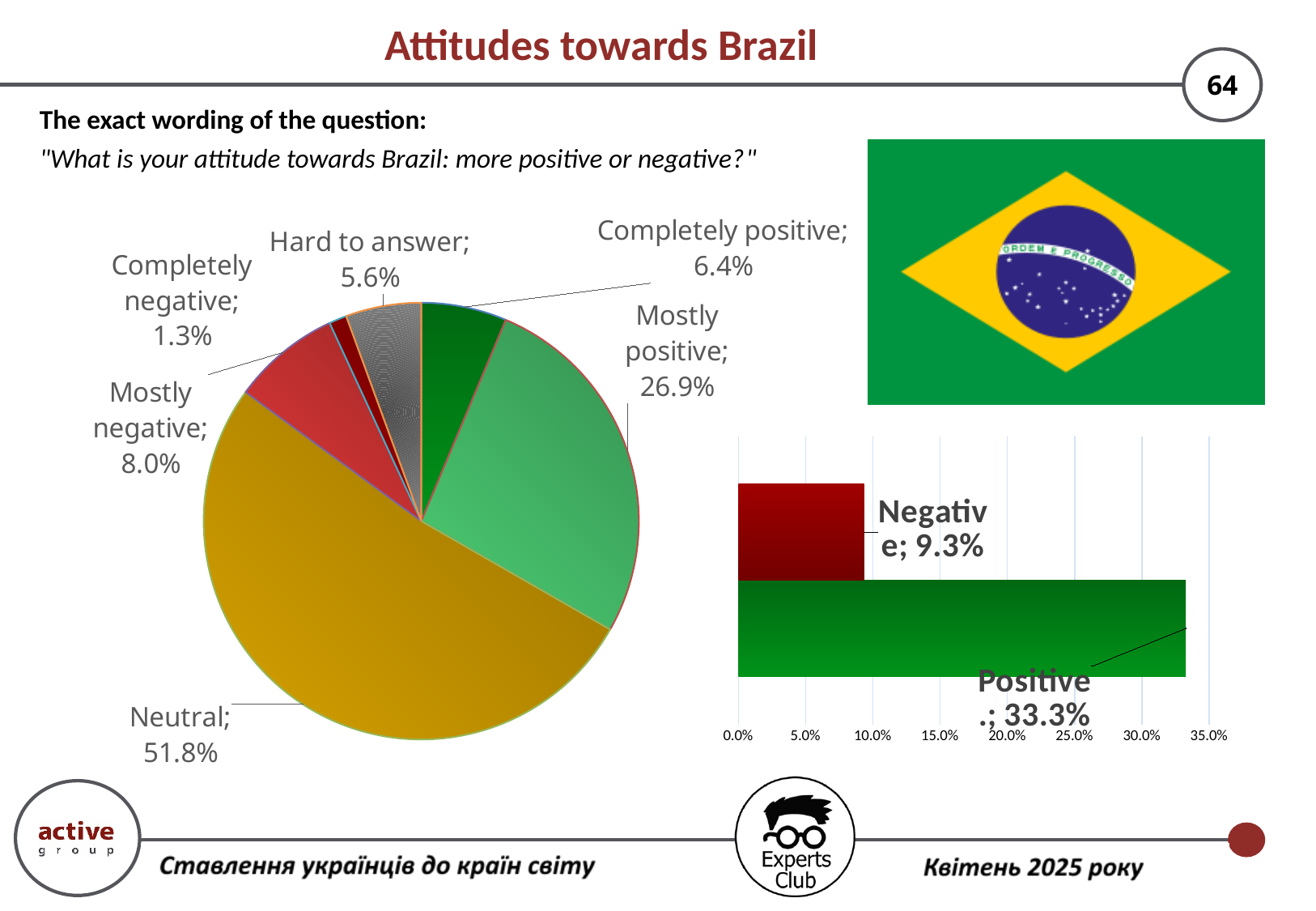
In the pie chart on the left, what share of respondents answered "Completely negative"? 1.3% In the pie chart on the left, what share of respondents answered "Neutral"? 51.8% In the pie chart on the left, which category has the largest share? Neutral In the pie chart on the left, what share of respondents answered "Mostly positive"? 26.9% In the pie chart on the left, what is the difference between the "Mostly positive" and "Mostly negative" shares? 18.9% In the bar chart on the right, what is the value for "Positive"? 33.3% What type of chart is shown on the right side of the slide? Bar chart In the pie chart on the left, which category has the smallest share? Completely negative In the bar chart on the right, what is the value for "Negative"? 9.3% In the pie chart on the left, how many categories are shown? 6 In the pie chart on the left, which is larger: "Hard to answer" or "Completely positive"? Completely positive In the bar chart on the right, what is the difference between the "Positive" and "Negative" values? 24.0%